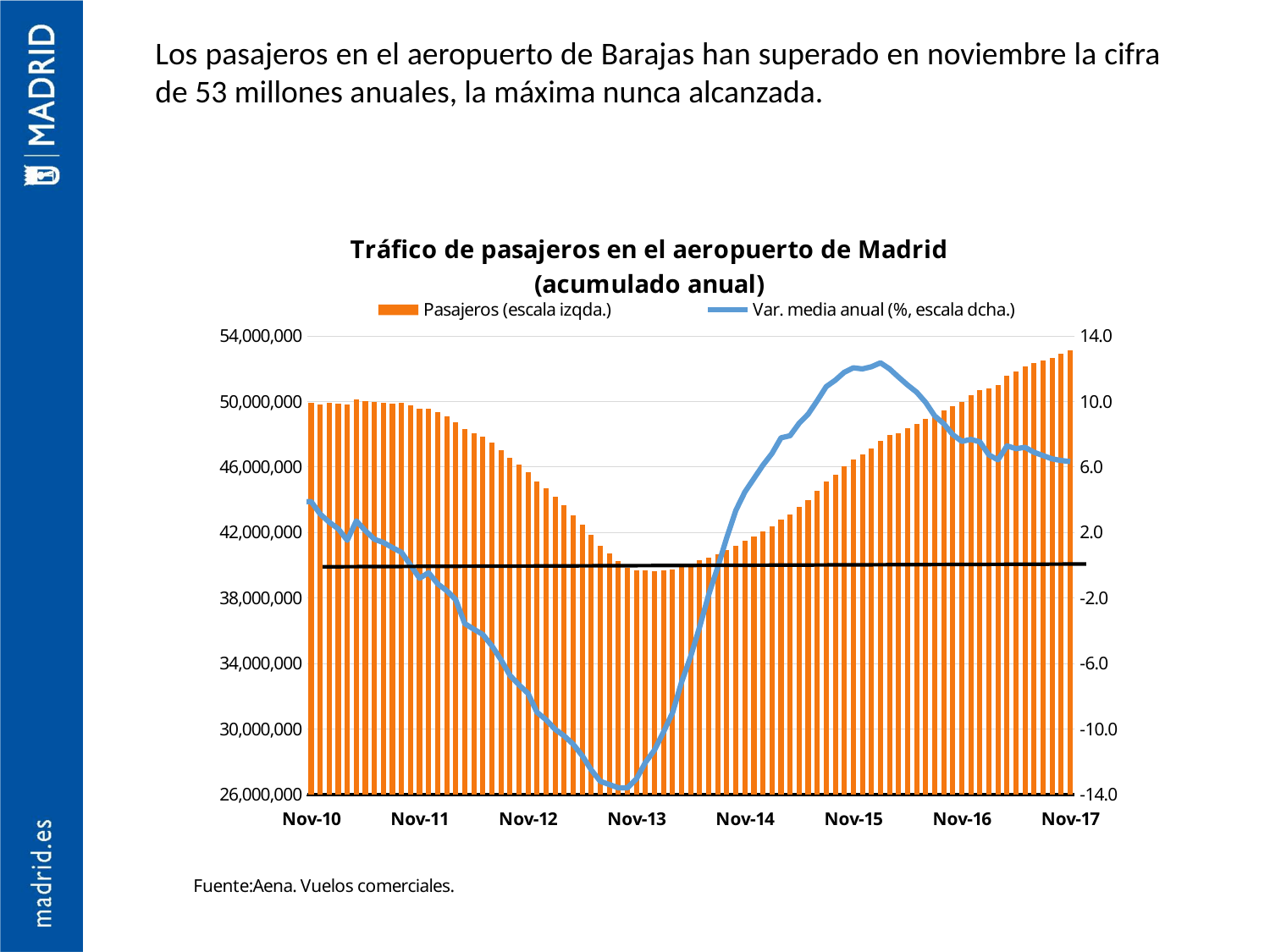
Which series is plotted as bars according to the legend? Pasajeros (escala izqda.) Is the Pasajeros bar for Nov-17 greater or less than 50,000,000? greater Among the labelled x-axis points, which has the highest Pasajeros bar? Nov-17 Is the Var. media anual line value at Nov-15 greater or less than 10.0? greater How many series does the legend list? 2 Which is larger, the Pasajeros bar for Nov-10 or for Nov-17? Nov-17 What is the title of the chart? Tráfico de pasajeros en el aeropuerto de Madrid (acumulado anual) Is the Var. media anual line value at Nov-13 greater or less than -10.0? less Do the Pasajeros bars rise or fall from Nov-13 to Nov-17? rise How many labelled points are shown on the x axis? 8 What kind of chart is shown on the slide? A combined bar and line chart